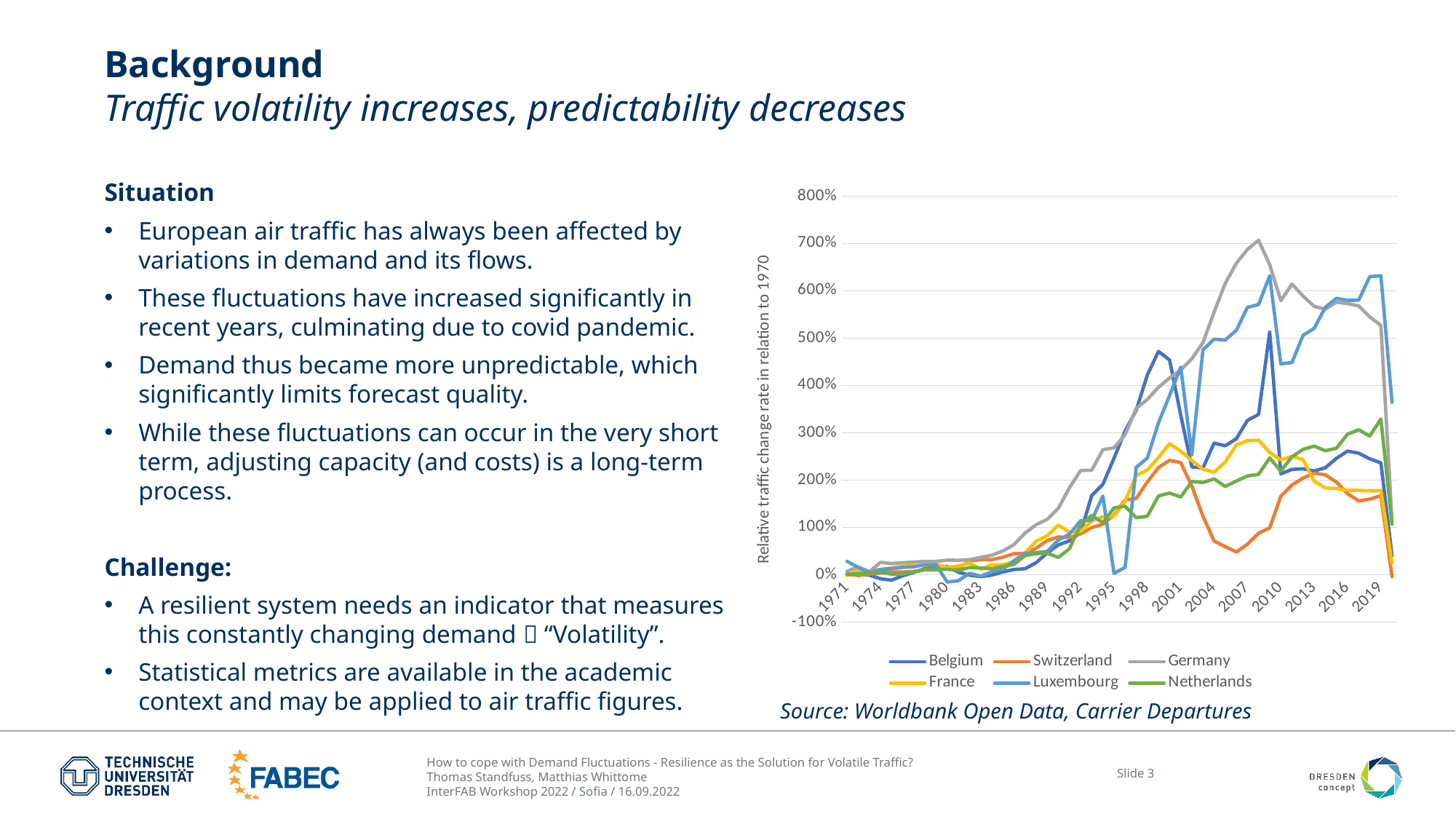
Is the value for Switzerland around 2007 greater or less than 100%? less Which series has the lowest value around 2007? Switzerland How many series does the chart legend list? 6 Around 2007, which series is larger, Germany or Switzerland? Germany Which countries are listed in the chart legend? Belgium, Switzerland, Germany, France, Luxembourg, Netherlands Is the peak value for Germany around 2007 greater or less than 600%? greater Does the Germany series rise or fall between 1971 and 2007? rise Is the peak value for Belgium around 1998 greater or less than 400%? greater What is the highest value shown on the vertical axis of the chart? 800% Which series reaches the highest peak value in the chart? Germany What kind of chart is shown on the slide? line chart What is the label of the vertical axis of the chart? Relative traffic change rate in relation to 1970